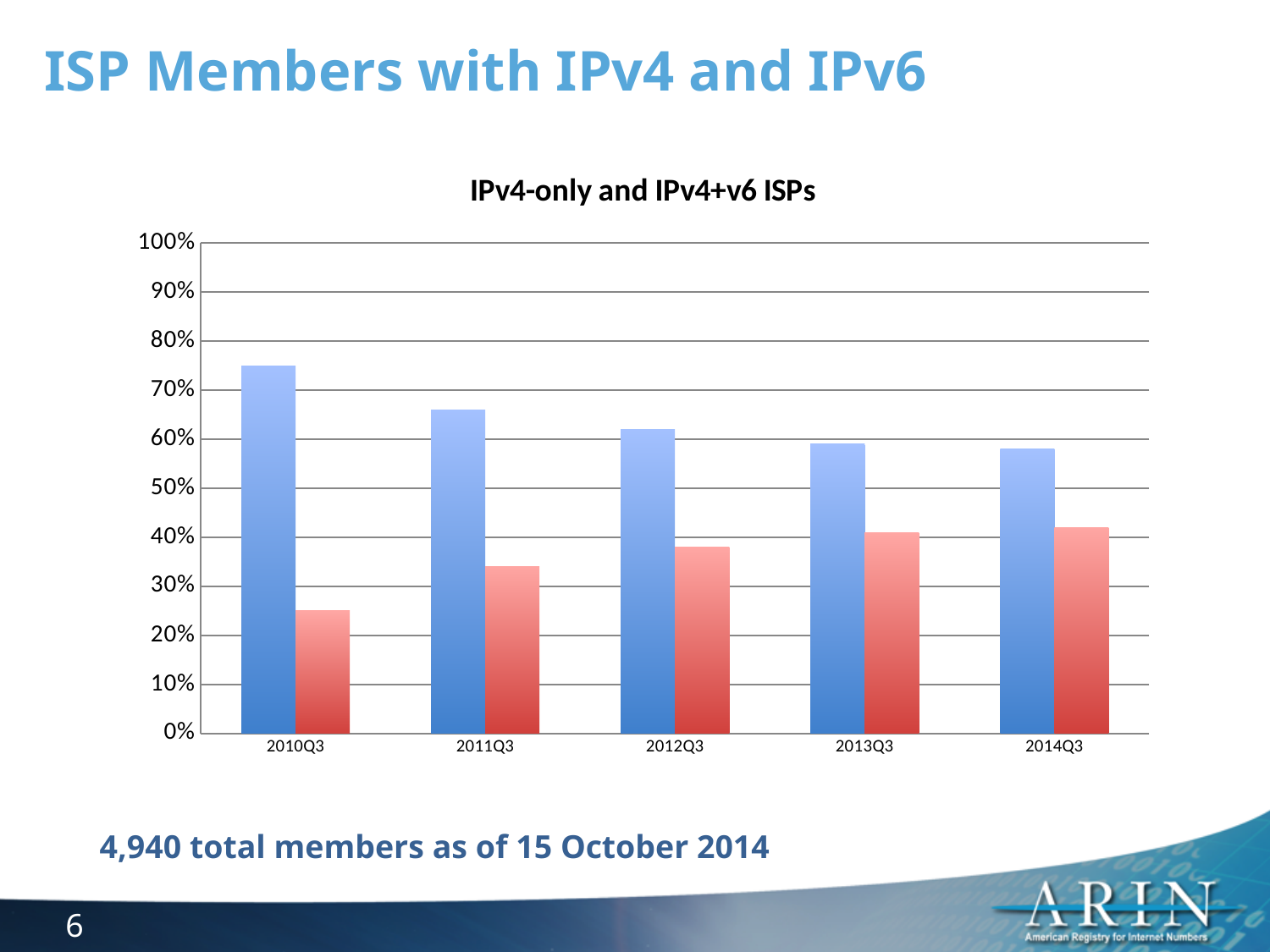
What is the title of the chart? IPv4-only and IPv4+v6 ISPs Is the value of the blue bar for 2010Q3 greater or less than 70%? greater How many bars are plotted for each quarter in the chart? 2 What kind of chart is shown on the slide? bar chart Is the value of the red bar for 2014Q3 greater or less than 50%? less Do the blue bars rise or fall from 2010Q3 to 2014Q3? fall In which quarter is the red bar lowest? 2010Q3 Is the value of the blue bar for 2014Q3 greater or less than 50%? greater In which quarter is the blue bar highest? 2010Q3 How many quarters are shown on the x axis of the chart? 5